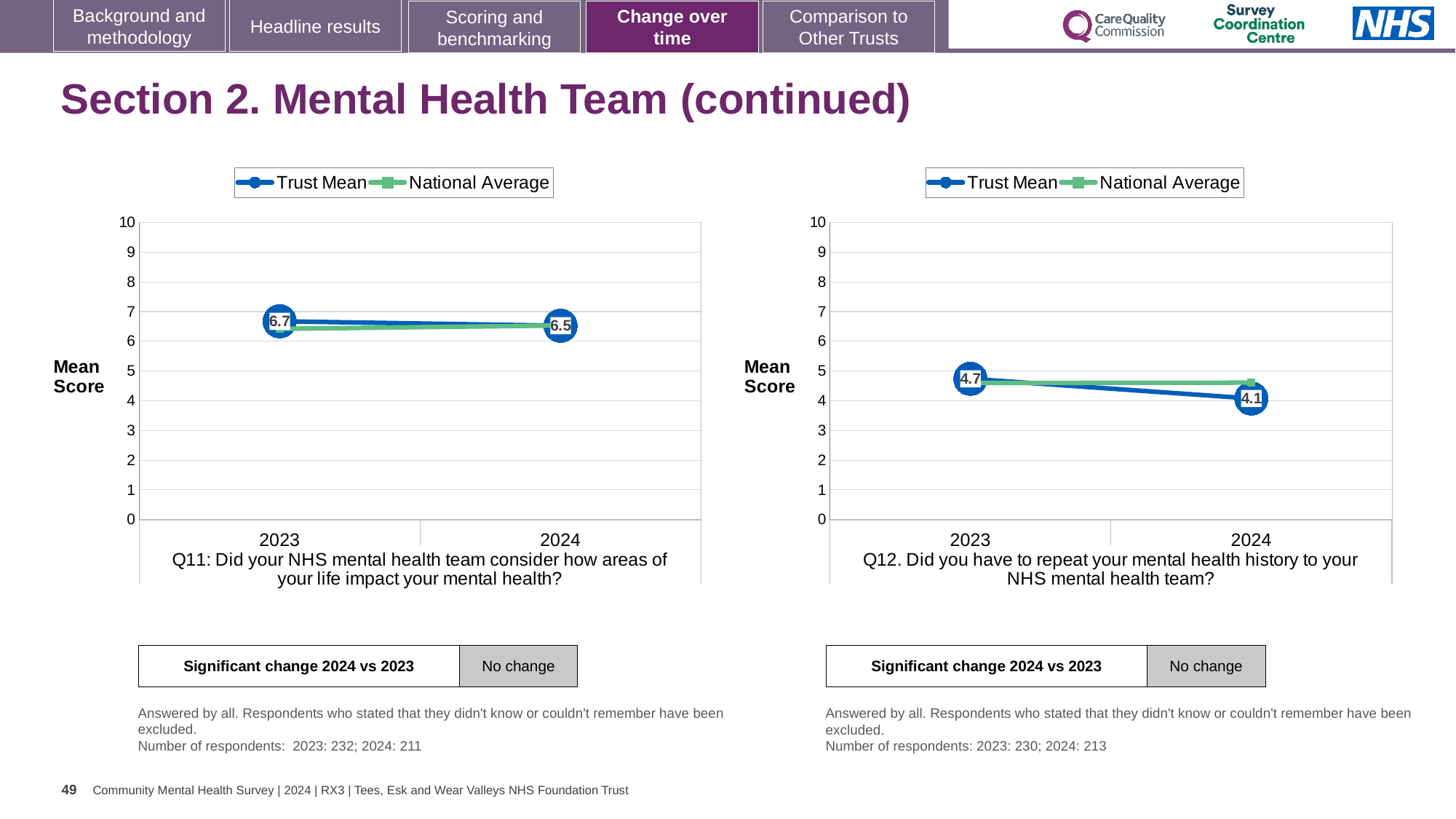
In the Q12 chart (right), what is the Trust Mean for 2024? 4.1 In the Q12 chart (right), what is the Trust Mean for 2023? 4.7 In the Q11 chart (left), what is the Trust Mean for 2024? 6.5 In the Q11 chart (left), which year has the higher Trust Mean, 2023 or 2024? 2023 What type of chart is used for Q11 (left)? line chart How many series does the legend of the Q11 chart (left) list? 2 In the Q11 chart (left), what is the Trust Mean for 2023? 6.7 In the Q11 chart (left), what is the difference between the Trust Mean in 2023 and 2024? 0.2 In the Q12 chart (right), does the Trust Mean rise or fall from 2023 to 2024? fall How many years are shown on the x axis of the Q12 chart (right)? 2 In the Q12 chart (right), by how much did the Trust Mean fall from 2023 to 2024? 0.6 In the Q12 chart (right), is the National Average for 2024 greater or less than 4? greater